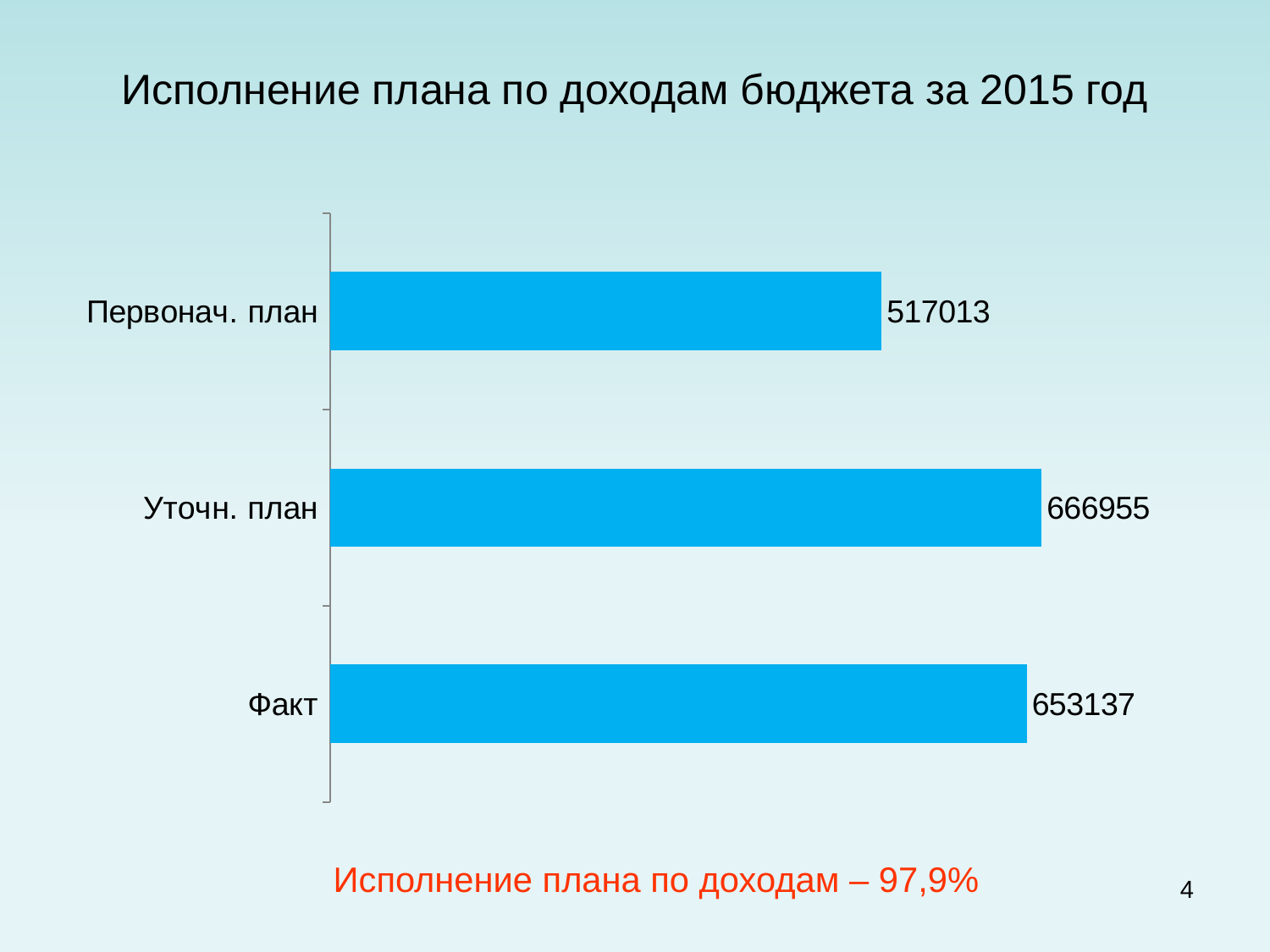
What is the value for Факт? 653137 How many categories are shown in the chart? 3 Which category has the highest value? Уточн. план What is the value for Первонач. план? 517013 What is the title of the slide? Исполнение плана по доходам бюджета за 2015 год Which is larger, Факт or Первонач. план? Факт Which category has the lowest value? Первонач. план What is the difference between Уточн. план and Факт? 13818 What kind of chart is shown on the slide? Bar chart What is the value for Уточн. план? 666955 What is the difference between Уточн. план and Первонач. план? 149942 What is the difference between Факт and Первонач. план? 136124